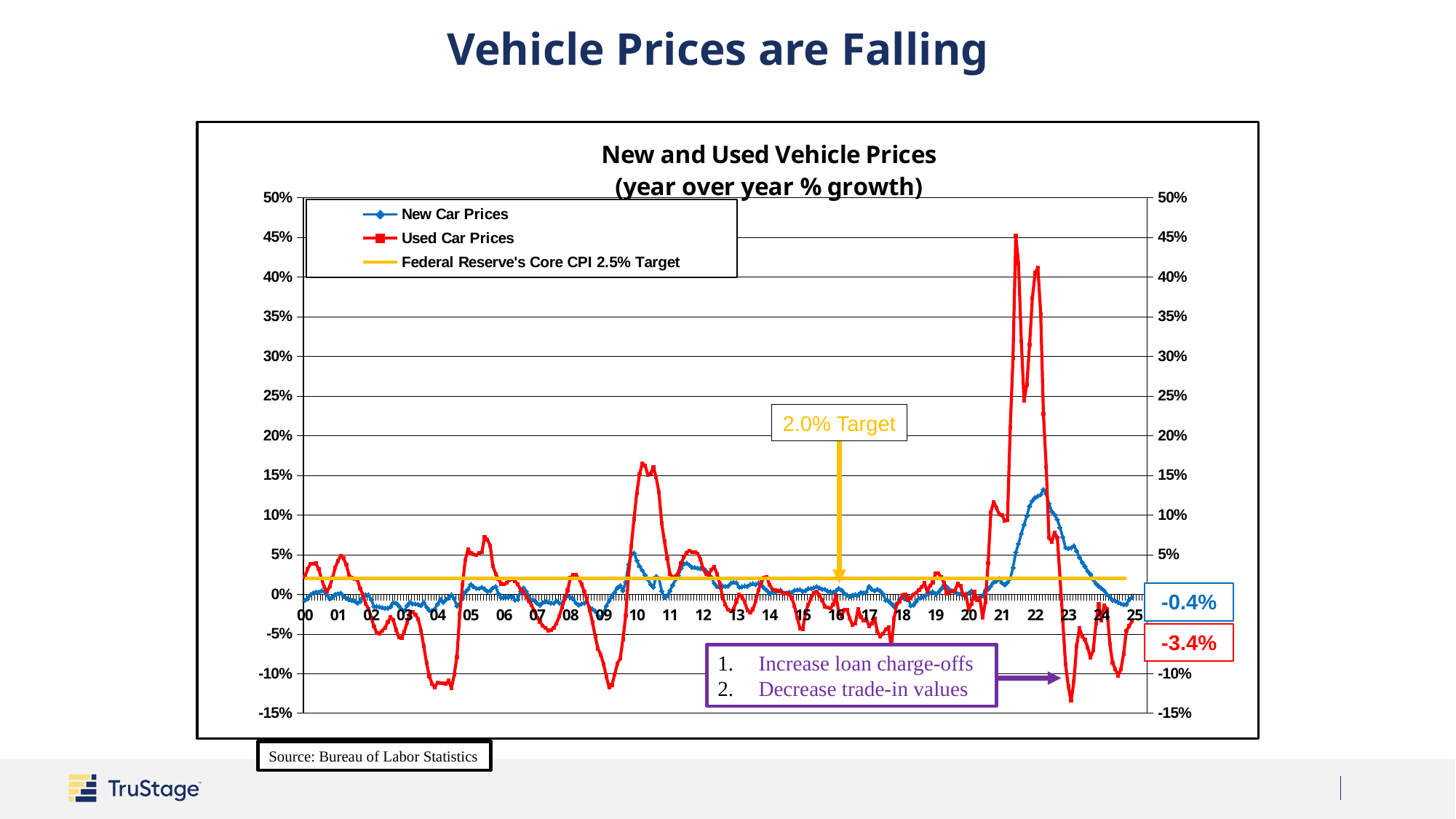
How many series does the chart legend list? 3 What is the difference between the latest New Car Prices value (-0.4%) and the latest Used Car Prices value (-3.4%)? 3.0 percentage points What is the latest labelled value for Used Car Prices? -3.4% Which is higher at the end of the chart, the New Car Prices value or the Used Car Prices value? New Car Prices Is the lowest value for Used Car Prices around 2023 greater or less than -10%? less Is the peak value for Used Car Prices around 2021 greater or less than 40%? greater What is the title of the chart? New and Used Vehicle Prices (year over year % growth) What is the latest labelled value for New Car Prices? -0.4% What kind of chart is shown on the slide? Line chart Which series reaches the highest value anywhere on the chart? Used Car Prices Do Used Car Prices rise or fall between 2022 and 2023? Fall Is the peak value for New Car Prices around 2022 greater or less than 10%? greater